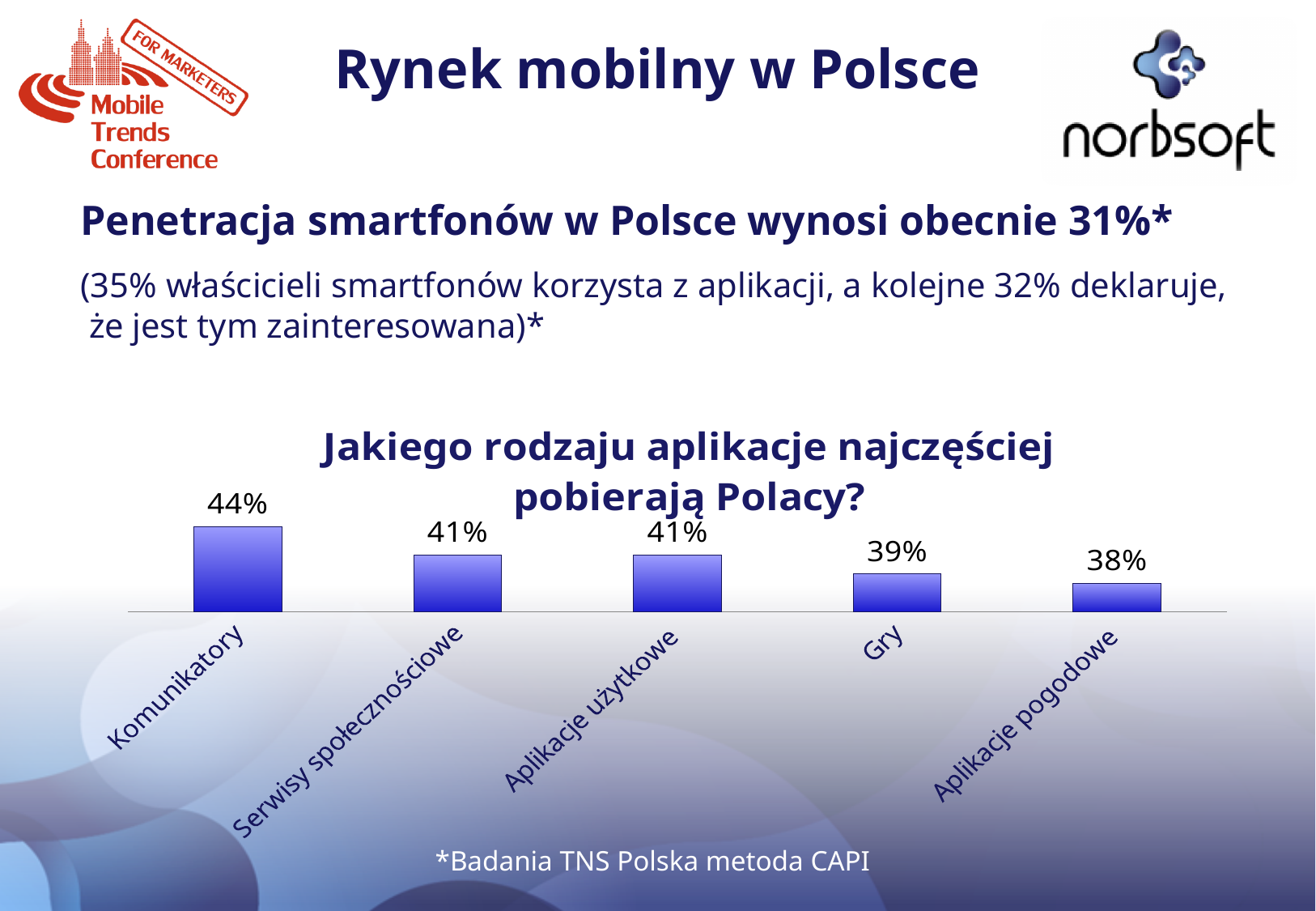
What is the value for Gry? 39% Which category has the highest value? Komunikatory What is the title of the chart? Jakiego rodzaju aplikacje najczęściej pobierają Polacy? What is the difference between the values for Komunikatory and Aplikacje pogodowe? 6% What is the value for Komunikatory? 44% Which is larger, the value for Komunikatory or the value for Gry? Komunikatory Which category has the lowest value? Aplikacje pogodowe What is the value for Aplikacje pogodowe? 38% What is the value for Serwisy społecznościowe? 41% How many categories are shown in the chart? 5 What kind of chart is shown on the slide? Bar chart What is the difference between the values for Aplikacje użytkowe and Gry? 2%